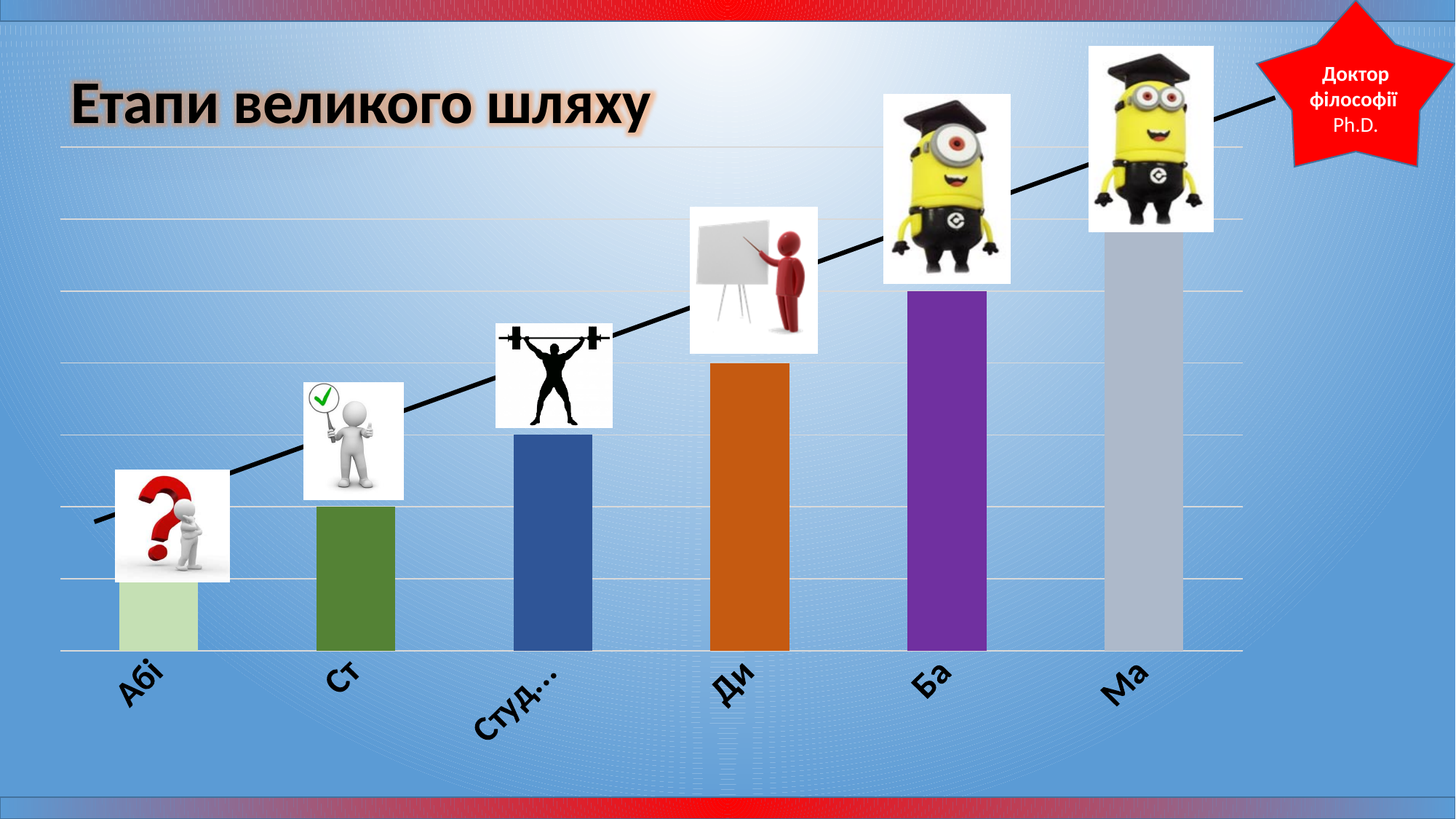
What kind of chart is shown on the slide? bar chart How many bars does the chart have? 6 Do the bar heights rise or fall from left to right along the x axis? rise Which category has the tallest bar? Ма What is the title of the slide containing the chart? Етапи великого шляху Which category has the shortest bar? Абі Which bar is taller, Абі or Ст? Ст What colour is the bar for Ди? orange Which bar is taller, Ст or Ди? Ди Which bar is taller, Ба or Студ...? Ба Which category is second from the left on the x axis? Ст